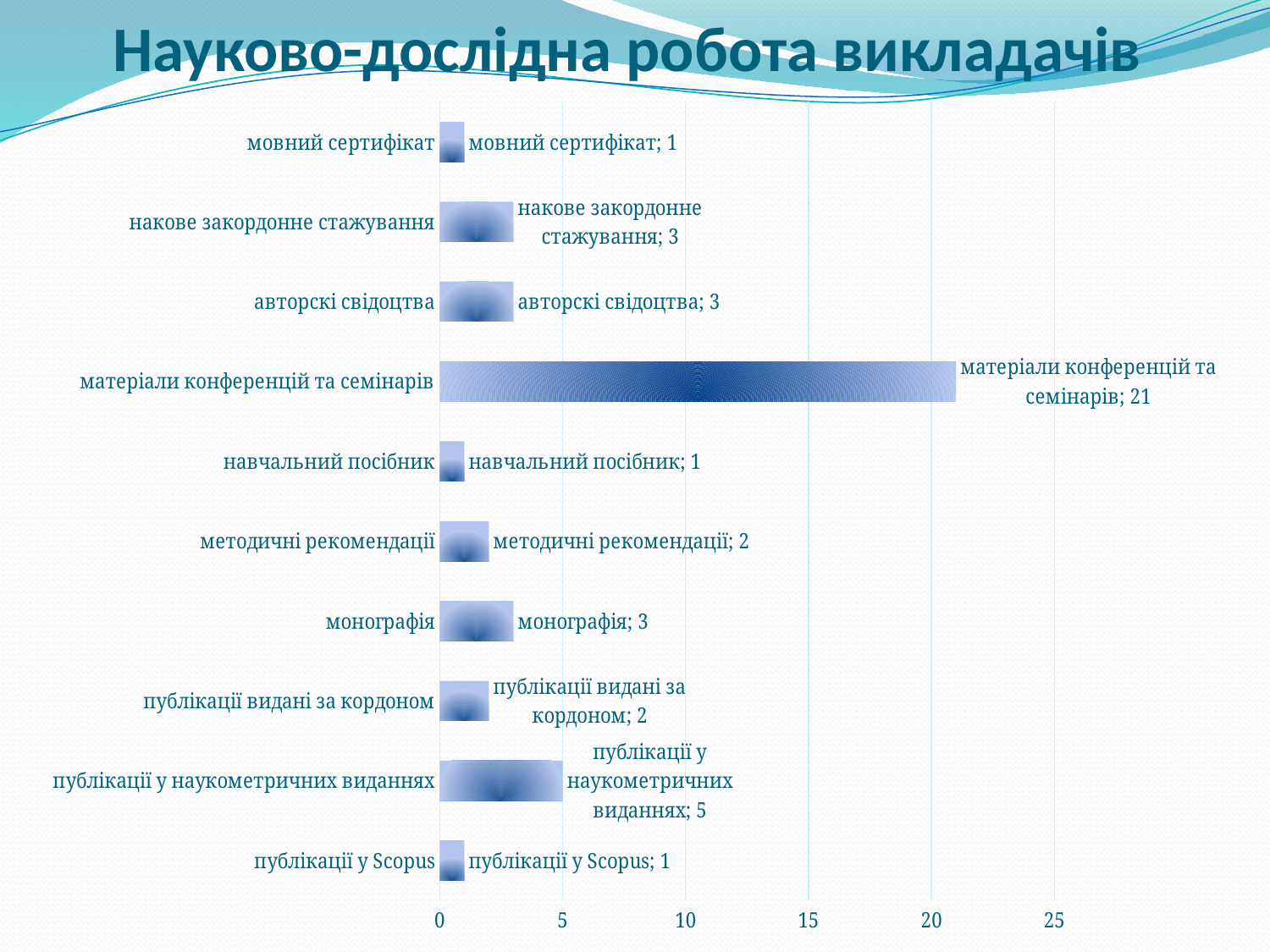
How many categories are shown in the chart? 10 What is the value for публікації у наукометричних виданнях? 5 What is the difference between the values for матеріали конференцій та семінарів and публікації у наукометричних виданнях? 16 What is the value for матеріали конференцій та семінарів? 21 Which is larger, the value for авторські свідоцтва or the value for публікації видані за кордоном? авторські свідоцтва What kind of chart is shown on the slide? bar chart What is the value for монографія? 3 Is the value for матеріали конференцій та семінарів greater or less than 20? greater What is the title of the slide? Науково-дослідна робота викладачів What is the value for публікації у Scopus? 1 What is the value for методичні рекомендації? 2 Which category has the highest value? матеріали конференцій та семінарів